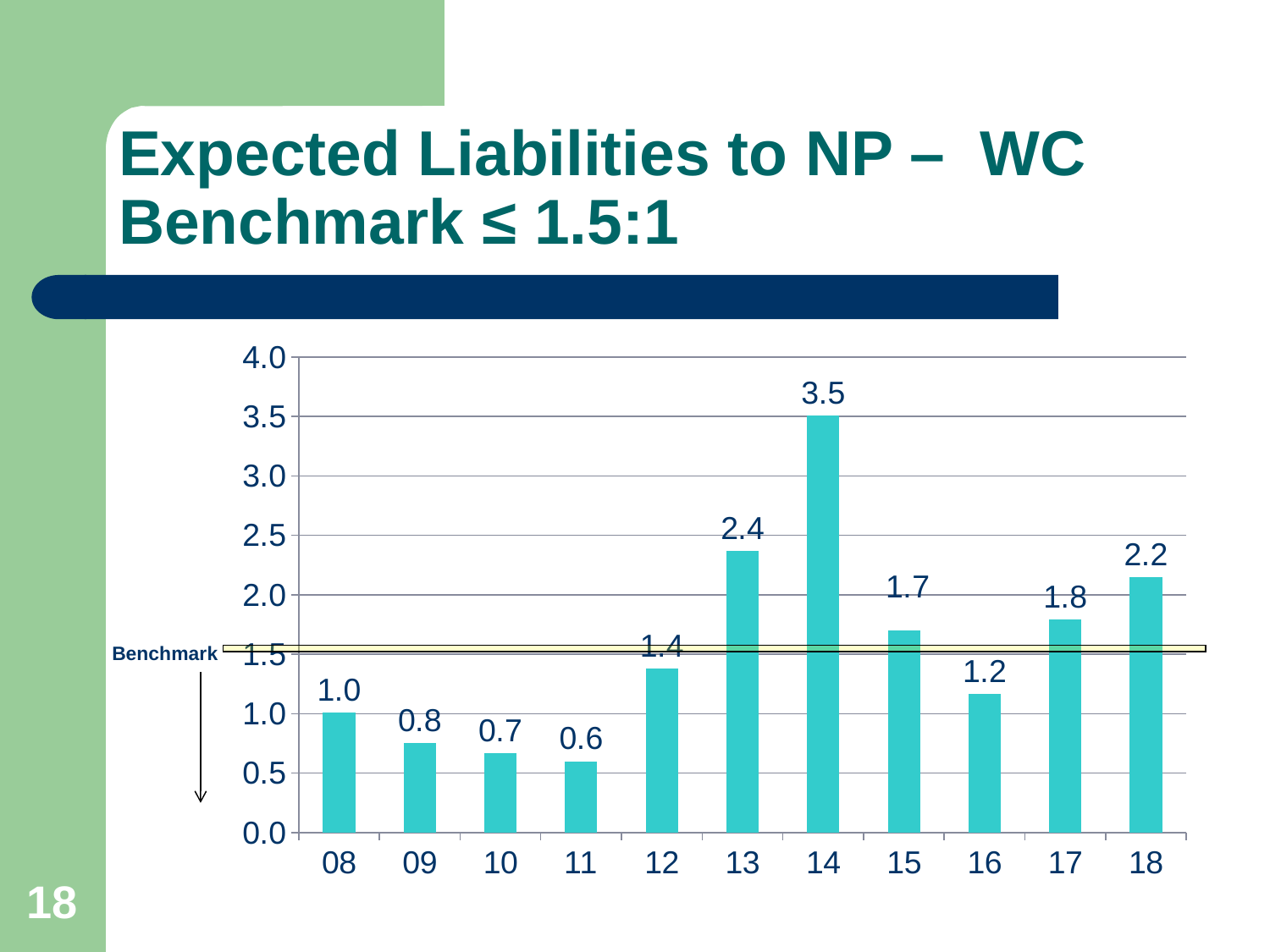
Which is larger, the value for 15 or the value for 17? 17 Do the values rise or fall from 08 to 11? fall Is the value for 16 greater or less than 1.5? less What is the value for 18? 2.2 Which year has the highest value? 14 What is the difference between the values for 14 and 13? 1.1 What is the value for 14? 3.5 What kind of chart is this? bar chart Which year has the lowest value? 11 At what value is the Benchmark line drawn? 1.5 How many years are shown on the x axis? 11 What is the value for 11? 0.6